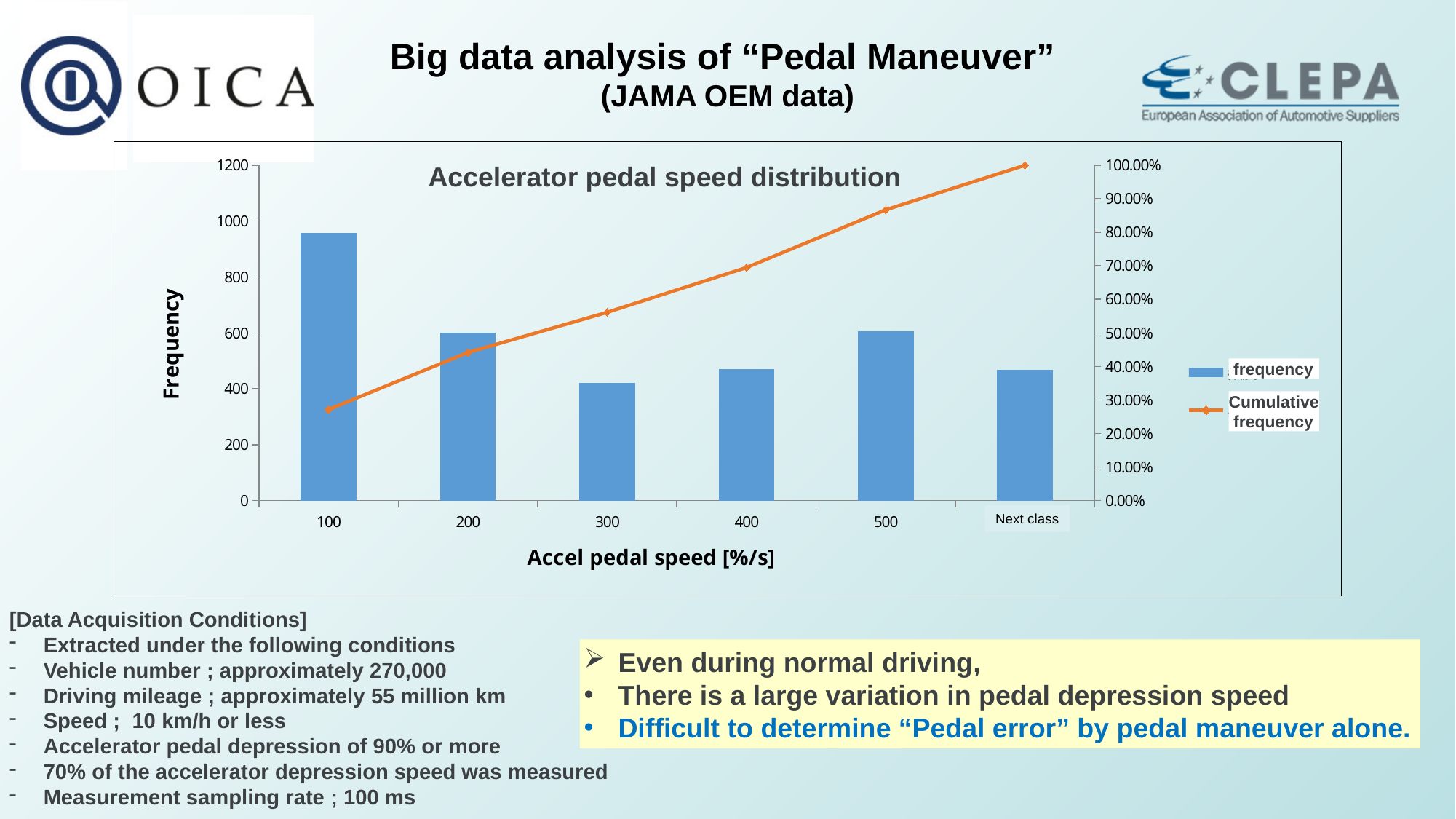
Which accel pedal speed category has the lowest frequency bar? 300 Is the frequency for the 100 category greater or less than 800? greater Is the frequency for the 300 category greater or less than 600? less Is the frequency for the 500 category greater or less than 400? greater Does the cumulative frequency line rise or fall as accel pedal speed increases along the x axis? rise Which is larger, the frequency bar for 100 or the frequency bar for 300? 100 How many series does the chart legend list? 2 Which accel pedal speed category has the highest frequency bar? 100 How many categories are shown on the x axis of the chart? 6 What is the title of the chart? Accelerator pedal speed distribution What is the cumulative frequency value at the 'Next class' category? 100.00%